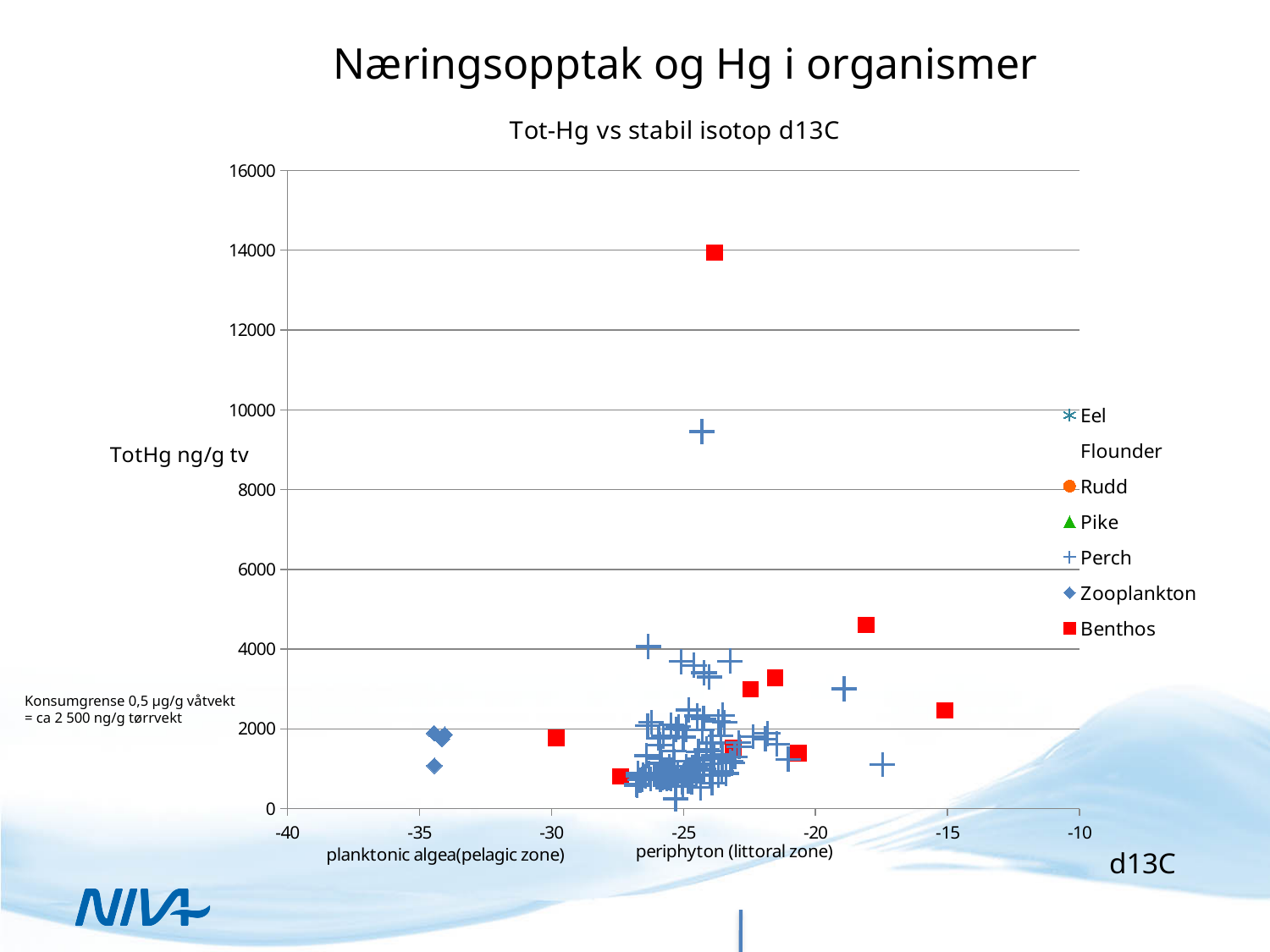
Which series has the single highest TotHg value plotted on the chart? Benthos What label is given to the horizontal axis of the chart? d13C Is the highest Perch point greater or less than 8000 ng/g tv? greater What is the title of the chart? Tot-Hg vs stabil isotop d13C Is the highest Benthos point greater or less than 12000 ng/g tv? greater What kind of chart is shown on the slide? scatter chart Which is higher on the chart: the highest Benthos point or the highest Perch point? the highest Benthos point Is the highest Perch point greater or less than 10000 ng/g tv? less What is the maximum value shown on the vertical axis? 16000 Which series is plotted with red square markers? Benthos How many series does the chart legend list? 7